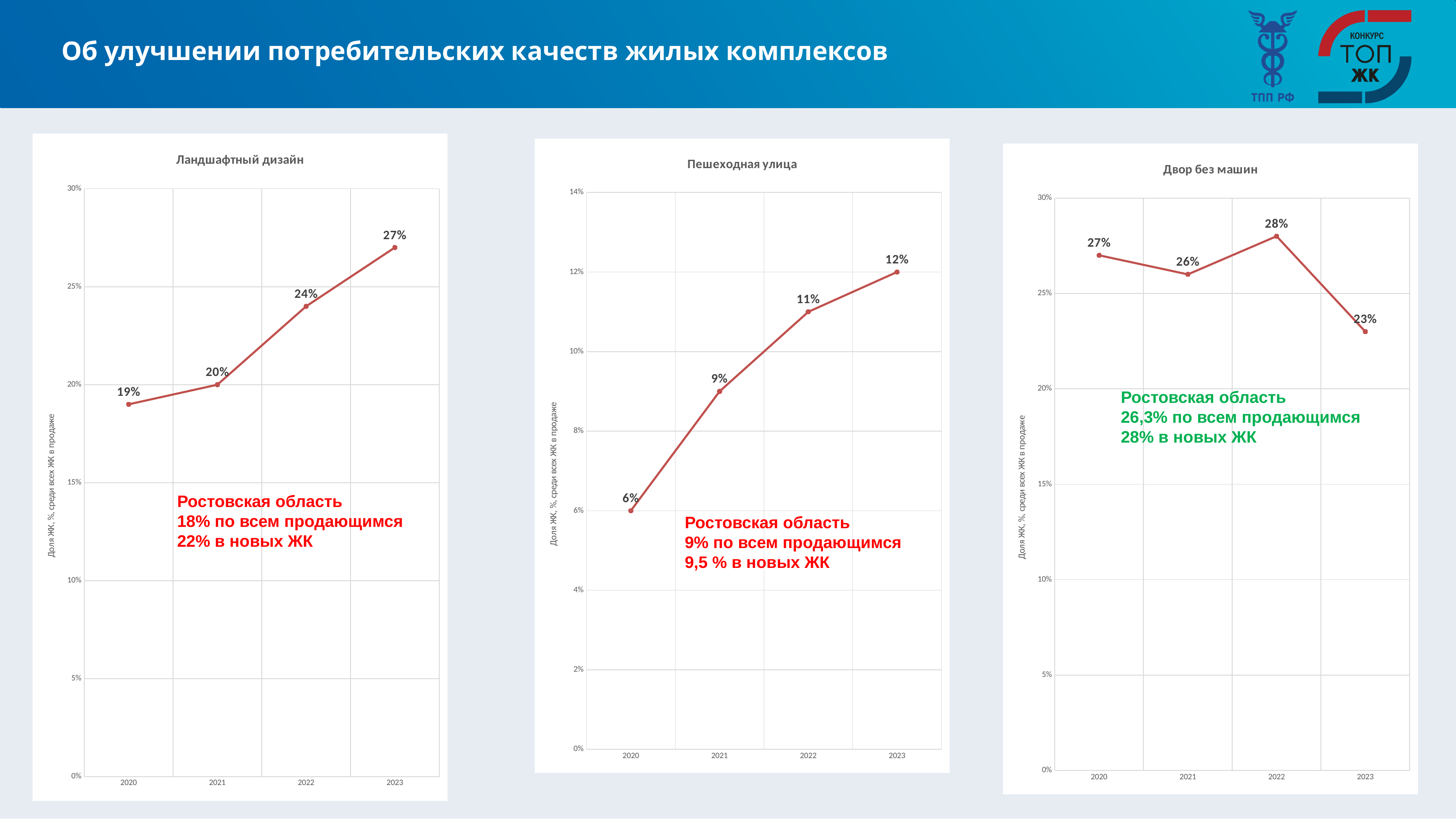
In the chart titled "Пешеходная улица", what is the difference between the 2023 and 2022 values? 1% What kind of chart is the chart titled "Двор без машин"? line chart In the chart titled "Пешеходная улица", what is the value for 2021? 9% In the chart titled "Пешеходная улица", which year has the lowest value? 2020 In the chart titled "Пешеходная улица", how many data points are plotted? 4 In the chart titled "Двор без машин", which is larger, the value for 2020 or the value for 2021? 2020 In the chart titled "Ландшафтный дизайн", what is the value for 2023? 27% In the chart titled "Двор без машин", which year has the highest value? 2022 In the chart titled "Ландшафтный дизайн", what is the difference between the 2023 and 2020 values? 8% In the chart titled "Ландшафтный дизайн", do the values rise or fall from 2020 to 2023? rise In the chart titled "Ландшафтный дизайн", what is the value for 2020? 19% In the chart titled "Двор без машин", what is the value for 2023? 23%